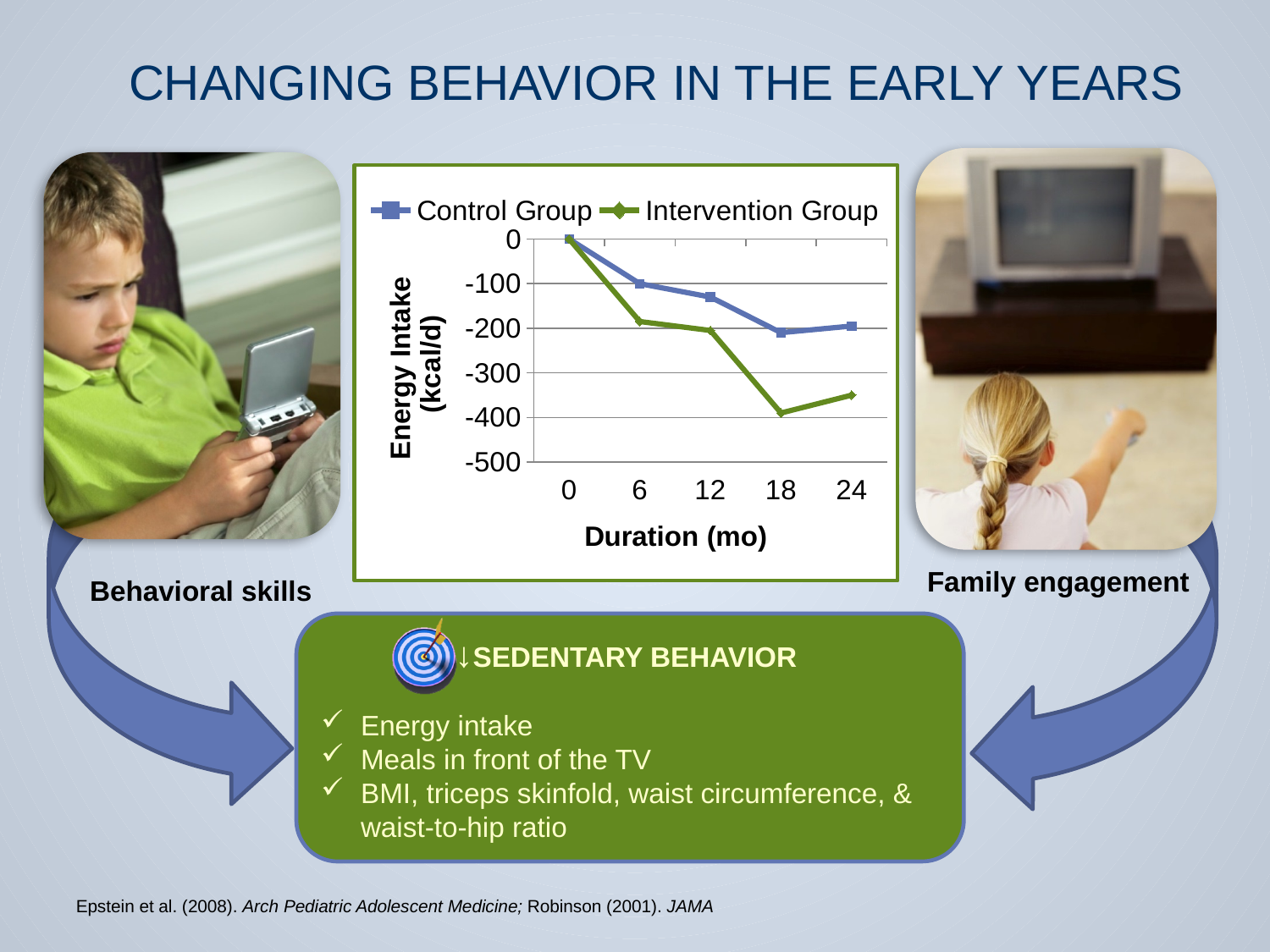
How many series does the chart's legend list? 2 How many time points are plotted along the x axis of the chart? 5 What is the energy intake value for the Intervention Group at 0 months? 0 Is the value for the Intervention Group at 24 months greater or less than -300? less Is the value for the Control Group at 18 months greater or less than -300? greater At which duration does the Intervention Group reach its lowest energy intake value? 18 Do the Intervention Group values generally rise or fall from 0 to 18 months? fall What is the label of the chart's x axis? Duration (mo) Is the value for the Intervention Group at 18 months greater or less than -300? less What are the two series named in the chart's legend? Control Group and Intervention Group At 18 months, which group has the lower energy intake value? Intervention Group What kind of chart is shown on the slide? line chart